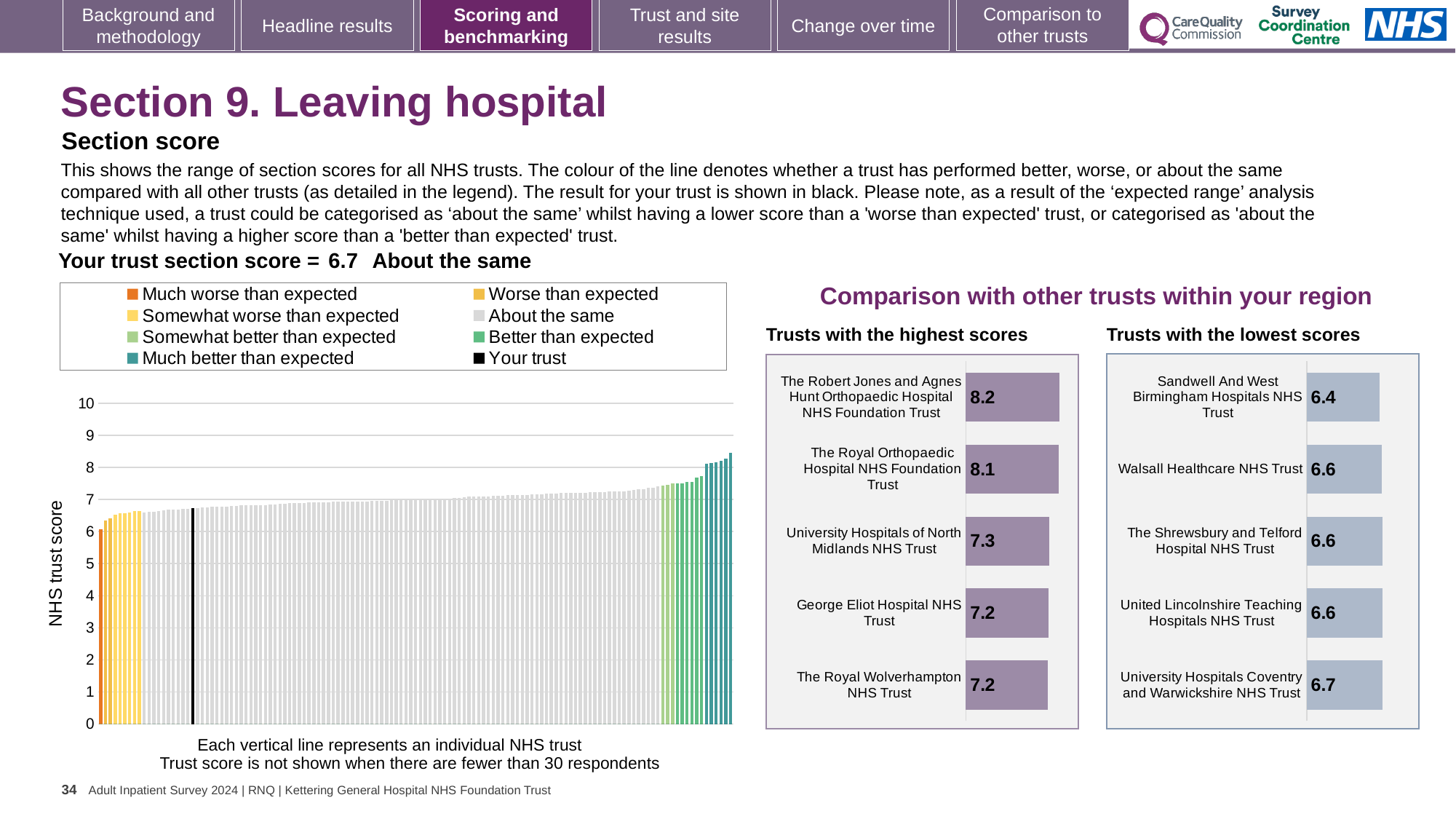
How many entries does the legend above the large 'NHS trust score' chart list? 8 In the 'Trusts with the lowest scores' chart, what is the score for University Hospitals Coventry and Warwickshire NHS Trust? 6.7 In the large 'NHS trust score' chart on the left, is the value of the tallest bar greater or less than 8? greater In the 'Trusts with the lowest scores' chart, which trust has the lowest score? Sandwell And West Birmingham Hospitals NHS Trust In the 'Trusts with the highest scores' chart, what is the score for The Robert Jones and Agnes Hunt Orthopaedic Hospital NHS Foundation Trust? 8.2 What kind of chart is the large 'NHS trust score' chart on the left of the slide? Bar chart How many trusts are listed in the 'Trusts with the highest scores' chart? 5 In the 'Trusts with the lowest scores' chart, what is the difference between the scores of University Hospitals Coventry and Warwickshire NHS Trust and Sandwell And West Birmingham Hospitals NHS Trust? 0.3 In the large 'NHS trust score' chart on the left, do the values rise or fall from left to right? Rise In the 'Trusts with the highest scores' chart, which has the higher score: University Hospitals of North Midlands NHS Trust or George Eliot Hospital NHS Trust? University Hospitals of North Midlands NHS Trust In the 'Trusts with the highest scores' chart, which trust has the highest score? The Robert Jones and Agnes Hunt Orthopaedic Hospital NHS Foundation Trust In the 'Trusts with the highest scores' chart, what is the difference between the scores of The Robert Jones and Agnes Hunt Orthopaedic Hospital NHS Foundation Trust and The Royal Orthopaedic Hospital NHS Foundation Trust? 0.1